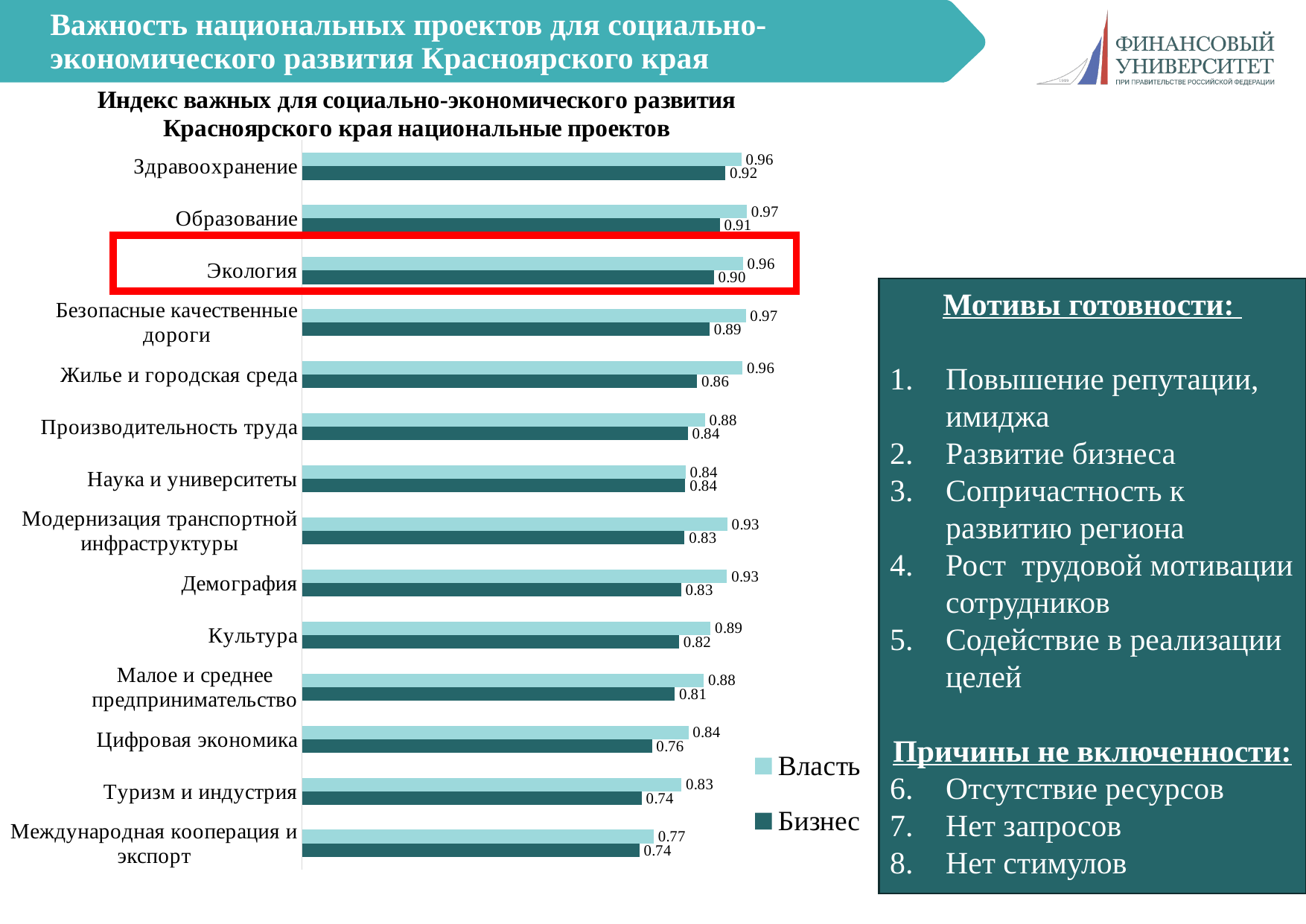
How many categories (national projects) are shown in the chart? 14 Which category is highlighted with a red box in the chart? Экология How many series does the legend list in the chart? 2 What is the value for Бизнес for Жилье и городская среда? 0.86 Which is larger for Туризм и индустрия: the Власть value or the Бизнес value? Власть What is the value for Власть for Экология? 0.96 What is the value for Бизнес for Цифровая экономика? 0.76 Which category has the lowest value for Власть? Международная кооперация и экспорт What type of chart is shown on the slide? bar chart Which category has the highest value for Бизнес? Здравоохранение What is the difference between the Власть and Бизнес values for Безопасные качественные дороги? 0.08 Which series is shown in the darker colour in the chart? Бизнес